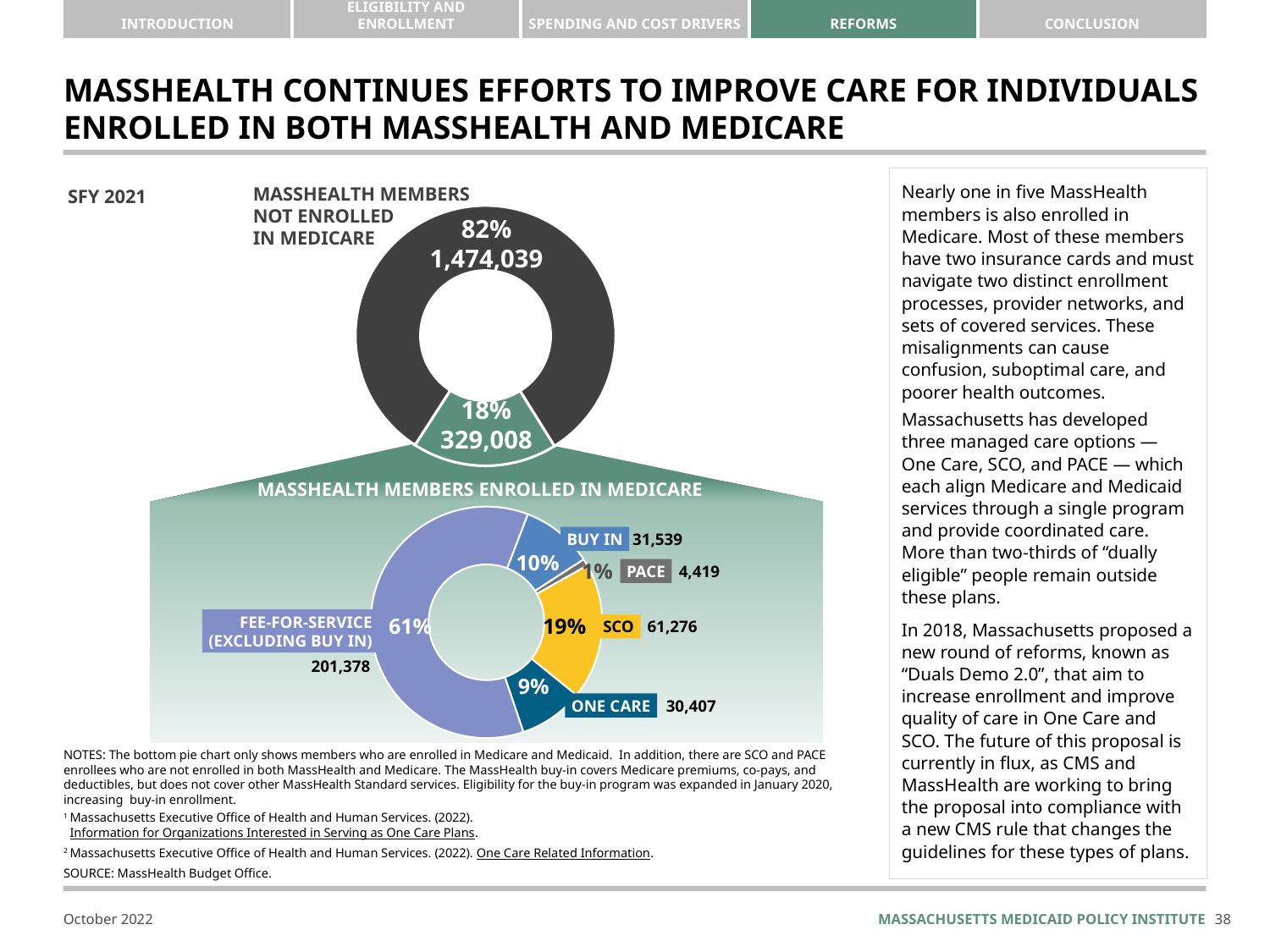
In the bottom chart of MassHealth members enrolled in Medicare, which category has the largest share? Fee-for-service (excluding buy in) What type of chart is used to show MassHealth members enrolled in Medicare? Donut (pie) chart How many categories are shown in the bottom chart of MassHealth members enrolled in Medicare? 5 In the bottom chart of MassHealth members enrolled in Medicare, which has more members, Buy In or PACE? Buy In In the bottom chart of MassHealth members enrolled in Medicare, how many members are in SCO? 61,276 In the bottom chart of MassHealth members enrolled in Medicare, what share of members are in One Care? 9% In the top donut chart, how many MassHealth members are not enrolled in Medicare? 1,474,039 In the top donut chart, what percentage of MassHealth members are not enrolled in Medicare? 82% In the top donut chart, how many MassHealth members are enrolled in Medicare? 329,008 In the bottom chart of MassHealth members enrolled in Medicare, which category has the smallest share? PACE What fiscal year is shown on the slide for the charts? SFY 2021 In the bottom chart of MassHealth members enrolled in Medicare, how many more members are in SCO than in One Care? 30,869